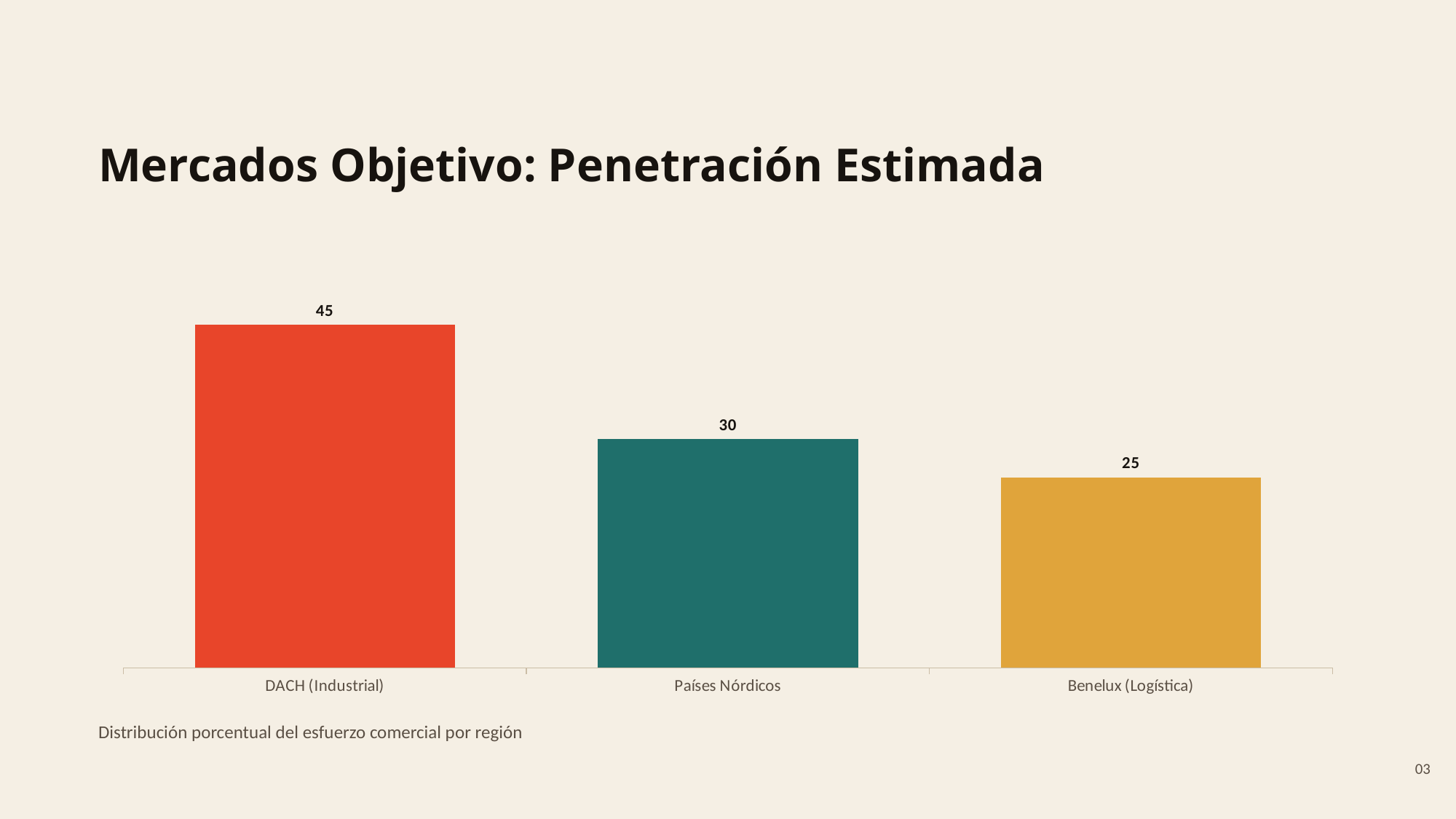
What is the value for Países Nórdicos? 30 What is the value for DACH (Industrial)? 45 What is the difference between the values for Países Nórdicos and Benelux (Logística)? 5 What kind of chart is shown on the slide? Bar chart What is the title of the slide containing the chart? Mercados Objetivo: Penetración Estimada Which category has the lowest value? Benelux (Logística) Which is larger, the value for Países Nórdicos or the value for Benelux (Logística)? Países Nórdicos What is the difference between the values for DACH (Industrial) and Países Nórdicos? 15 Do the values rise or fall from left to right across the categories? Fall Which category has the highest value? DACH (Industrial) What is the value for Benelux (Logística)? 25 How many categories are shown in the chart? 3